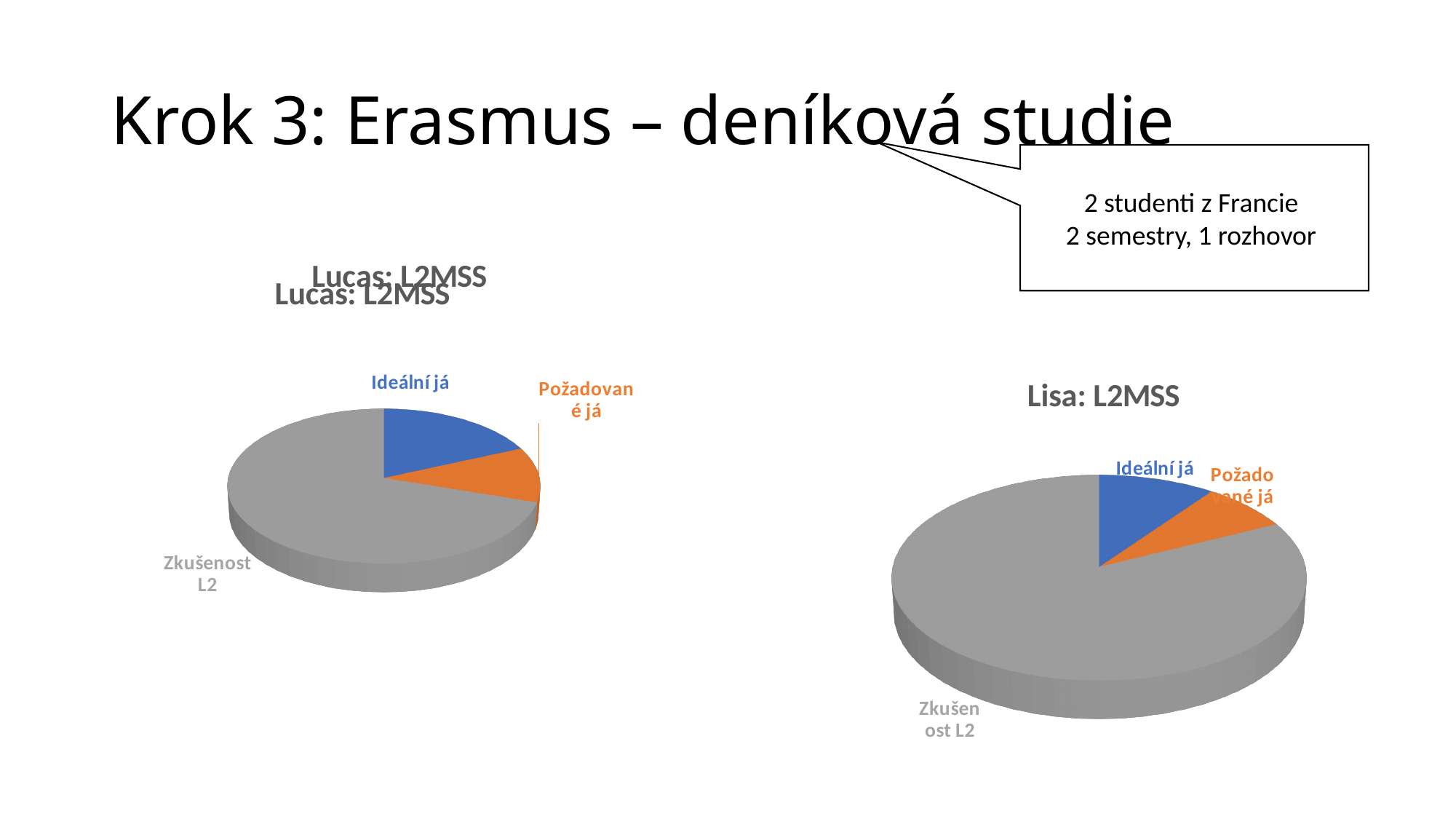
How many slices does the "Lisa: L2MSS" pie chart have? 3 In the "Lisa: L2MSS" chart, which category has the largest slice? Zkušenost L2 In the "Lisa: L2MSS" chart, which slice is larger: Zkušenost L2 or Ideální já? Zkušenost L2 In the "Lucas: L2MSS" chart, which category has the smallest slice? Požadované já In the "Lucas: L2MSS" chart, which slice is larger: Ideální já or Požadované já? Ideální já How many slices does the "Lucas: L2MSS" pie chart have? 3 In the "Lucas: L2MSS" chart, which category has the largest slice? Zkušenost L2 What colour is the Ideální já slice in the "Lucas: L2MSS" chart? blue What is the title of the pie chart on the right side of the slide? Lisa: L2MSS What kind of chart is the "Lucas: L2MSS" chart? pie chart What kind of chart is the "Lisa: L2MSS" chart? pie chart